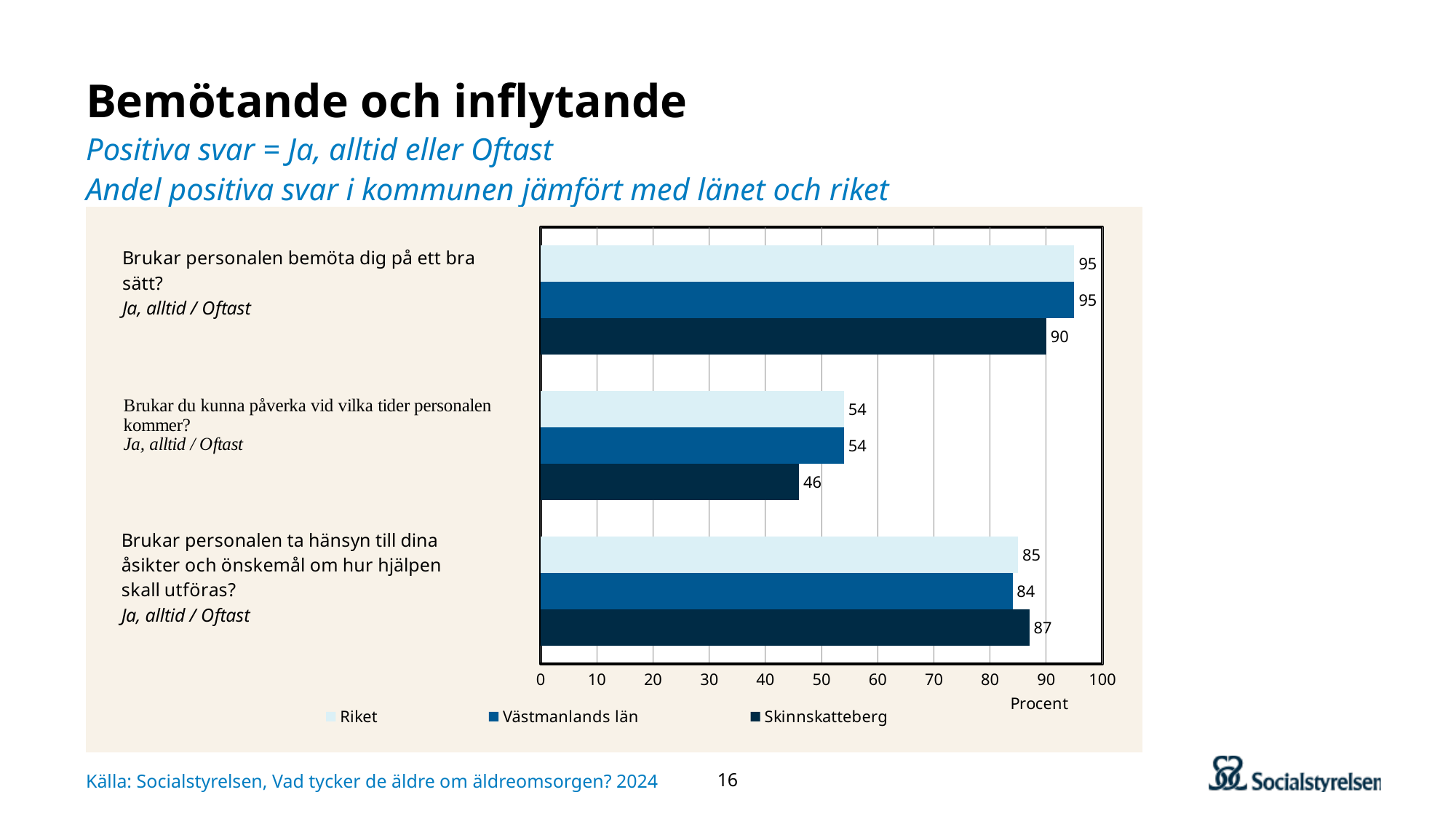
How many questions (categories) are shown in the chart? 3 How many series does the legend list? 3 What is the value for Riket on the question "Brukar du kunna påverka vid vilka tider personalen kommer?"? 54 What kind of chart is shown on the slide? bar chart What is the difference between the Riket value and the Skinnskatteberg value on the question "Brukar du kunna påverka vid vilka tider personalen kommer?"? 8 Is the value for Skinnskatteberg on "Brukar du kunna påverka vid vilka tider personalen kommer?" greater or less than 50? less What is the difference between the Västmanlands län value and the Skinnskatteberg value on the question "Brukar personalen bemöta dig på ett bra sätt?"? 5 What is the value for Västmanlands län on the question "Brukar personalen ta hänsyn till dina åsikter och önskemål om hur hjälpen skall utföras?"? 84 Which series has the lowest value on the question "Brukar du kunna påverka vid vilka tider personalen kommer?"? Skinnskatteberg Is the Skinnskatteberg value on "Brukar personalen ta hänsyn till dina åsikter och önskemål om hur hjälpen skall utföras?" larger or smaller than the Riket value on the same question? larger Which series has the highest value on the question "Brukar personalen ta hänsyn till dina åsikter och önskemål om hur hjälpen skall utföras?"? Skinnskatteberg What is the value for Skinnskatteberg on the question "Brukar personalen bemöta dig på ett bra sätt?"? 90